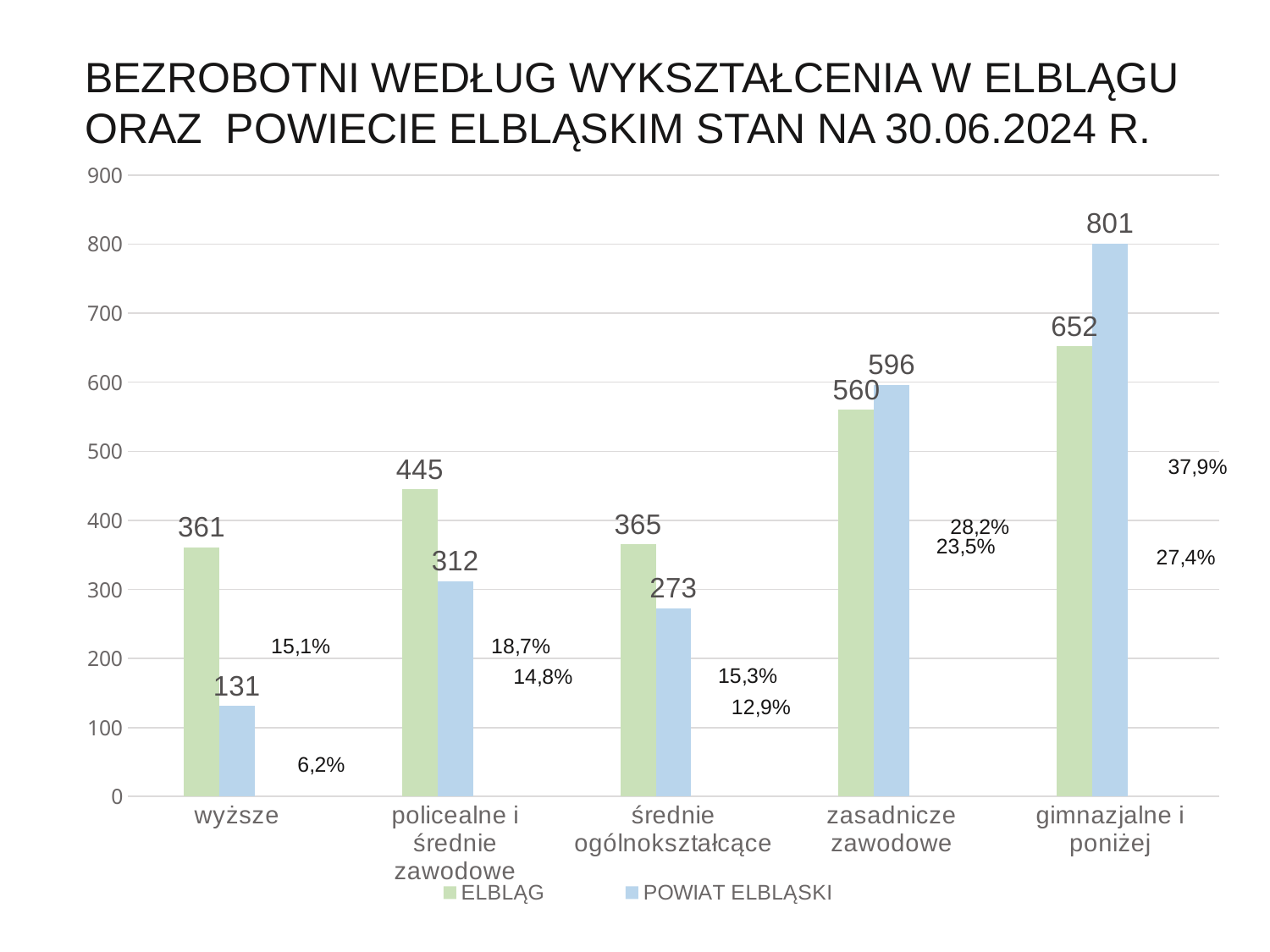
What is the difference between the POWIAT ELBLĄSKI and ELBLĄG values in the 'gimnazjalne i poniżej' category? 149 What is the value for ELBLĄG in the 'wyższe' category? 361 What kind of chart is shown on the slide? bar chart How many categories are shown on the x axis? 5 What is the value for POWIAT ELBLĄSKI in the 'gimnazjalne i poniżej' category? 801 Which category has the highest value for ELBLĄG? gimnazjalne i poniżej In the 'zasadnicze zawodowe' category, which series has the larger value, ELBLĄG or POWIAT ELBLĄSKI? POWIAT ELBLĄSKI How many series does the legend list? 2 In the 'policealne i średnie zawodowe' category, which series has the larger value, ELBLĄG or POWIAT ELBLĄSKI? ELBLĄG What is the value for POWIAT ELBLĄSKI in the 'średnie ogólnokształcące' category? 273 Which category has the lowest value for POWIAT ELBLĄSKI? wyższe What is the difference between the ELBLĄG and POWIAT ELBLĄSKI values in the 'wyższe' category? 230